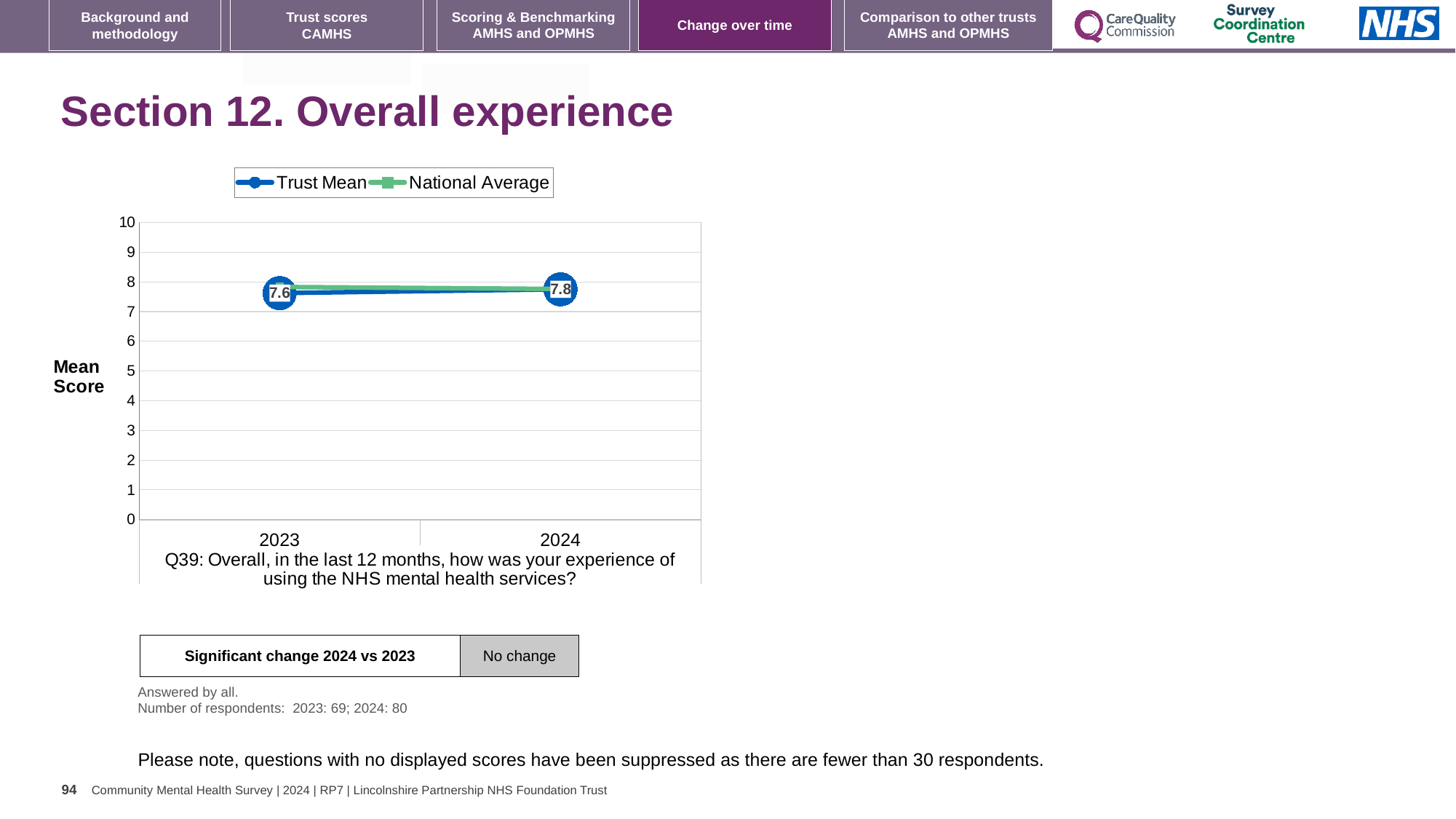
Is the National Average for 2024 greater or less than 6? greater What is the label on the y axis of the chart? Mean Score Which year has the higher Trust Mean, 2023 or 2024? 2024 Is the Trust Mean for 2023 greater or less than 5? greater What is the Trust Mean score for 2023? 7.6 How many years are shown on the x axis? 2 Does the Trust Mean rise or fall from 2023 to 2024? rise What are the two series named in the legend? Trust Mean and National Average What is the Trust Mean score for 2024? 7.8 How many series does the legend list? 2 What kind of chart is shown on the slide? line chart By how much did the Trust Mean change from 2023 to 2024? 0.2